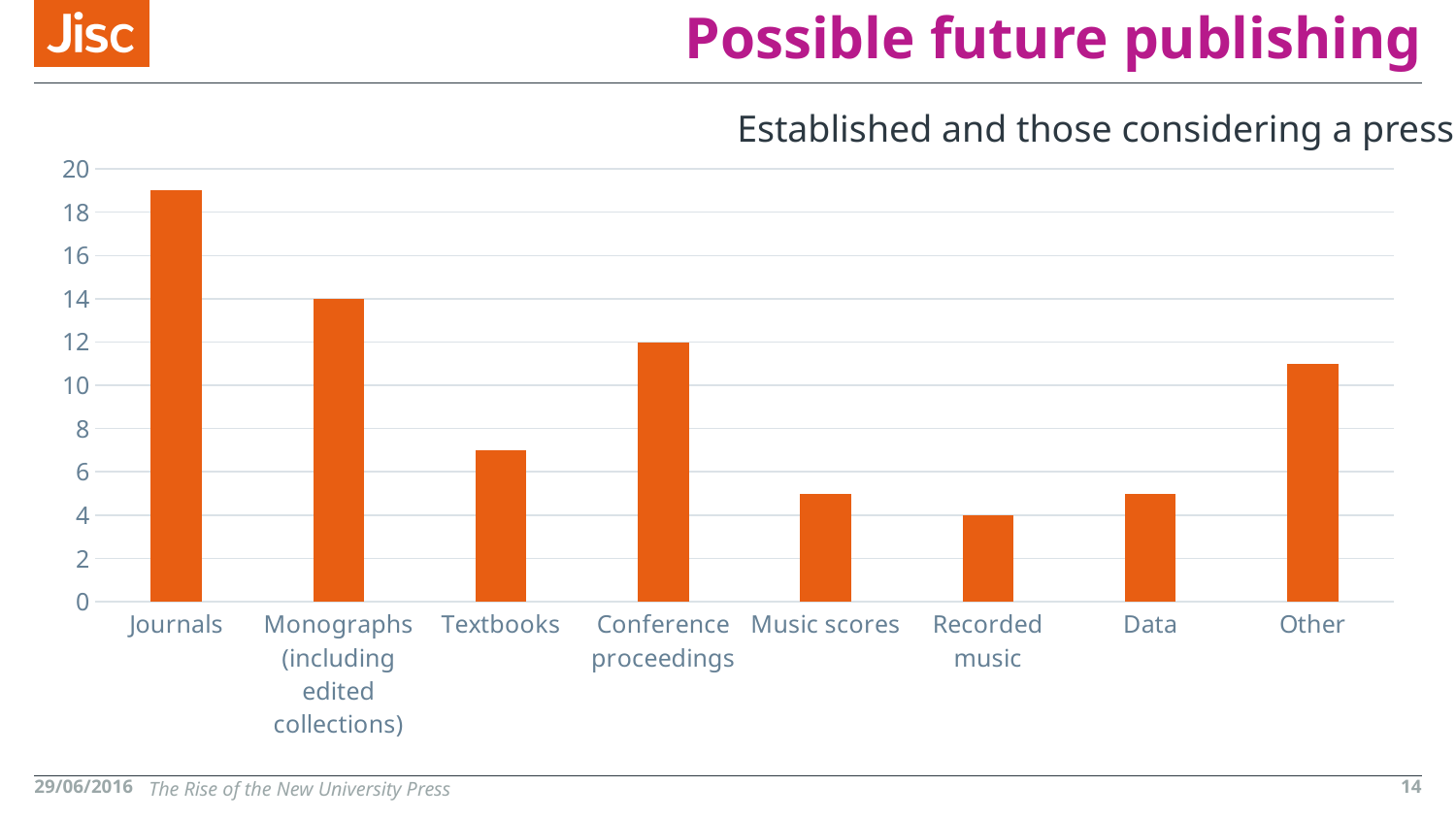
Which category has the highest value in the chart? Journals How many categories are shown on the x axis of the chart? 8 What type of chart is shown on the slide? bar chart What is the subtitle shown above the chart? Established and those considering a press Is the value for Textbooks greater or less than 8? less What is the value for Conference proceedings? 12 What is the value for Recorded music? 4 Is the value for Other greater or less than 10? greater What is the value for Monographs (including edited collections)? 14 What is the difference between the values for Monographs (including edited collections) and Conference proceedings? 2 Which is larger, the value for Journals or the value for Other? Journals Is the value for Journals greater or less than 18? greater